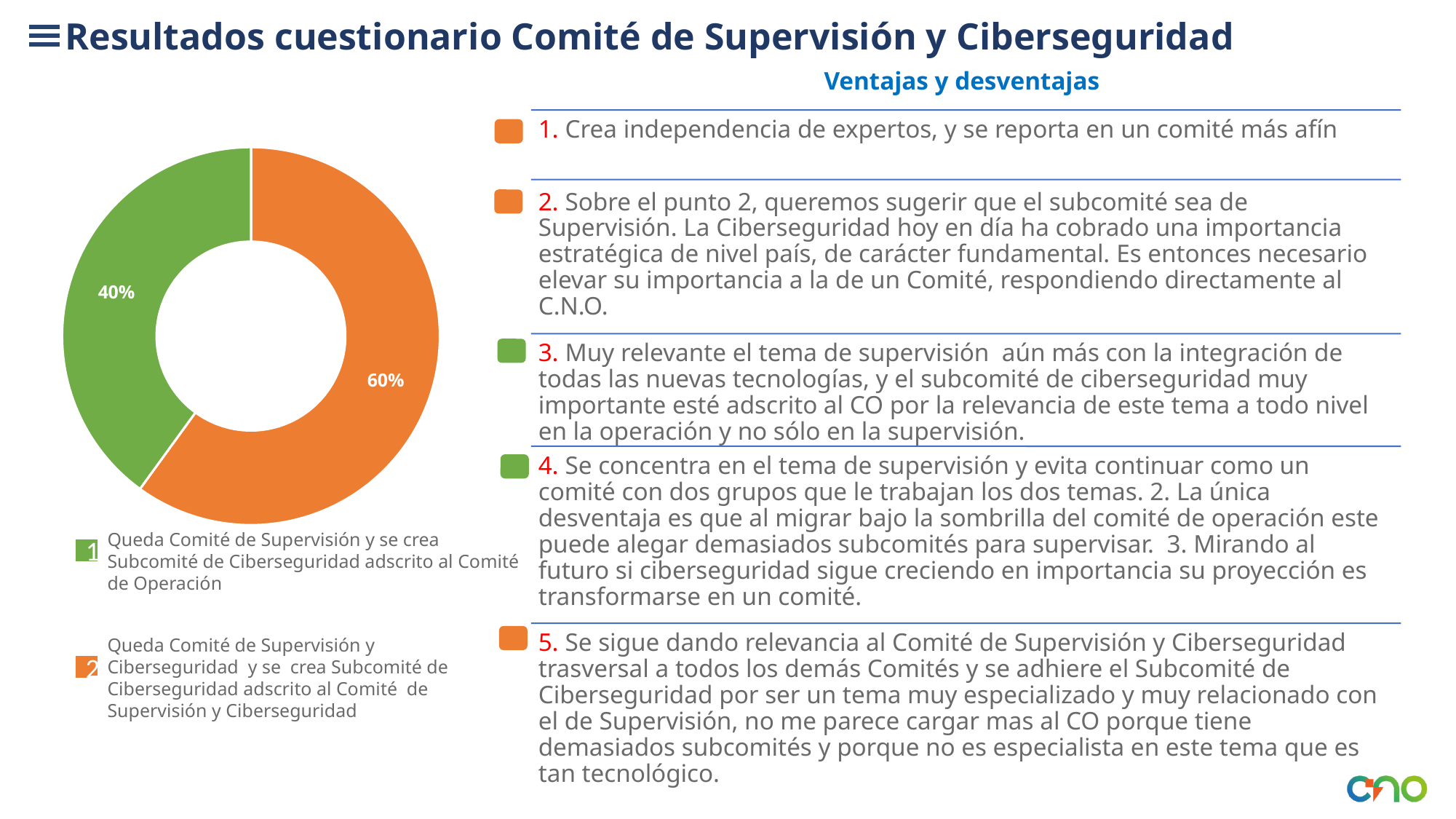
What percentage is shown for the orange slice of the donut chart? 60% What kind of chart is shown on the slide? Donut (pie) chart How many entries does the legend of the donut chart list? 2 What percentage is shown for the green slice of the donut chart? 40% What share of the donut chart corresponds to option 2, 'Queda Comité de Supervisión y Ciberseguridad y se crea Subcomité de Ciberseguridad adscrito al Comité de Supervisión y Ciberseguridad'? 60% What is the difference in percentage points between the orange slice and the green slice of the donut chart? 20 percentage points Which slice is larger in the donut chart, the orange one or the green one? The orange one How many slices does the donut chart have? 2 Which colour represents option 1 in the donut chart legend? Green What share of the donut chart corresponds to option 1, 'Queda Comité de Supervisión y se crea Subcomité de Ciberseguridad adscrito al Comité de Operación'? 40% Which option has the largest slice in the donut chart? Option 2 (Queda Comité de Supervisión y Ciberseguridad y se crea Subcomité de Ciberseguridad adscrito al Comité de Supervisión y Ciberseguridad) Which option has the smallest slice in the donut chart? Option 1 (Queda Comité de Supervisión y se crea Subcomité de Ciberseguridad adscrito al Comité de Operación)